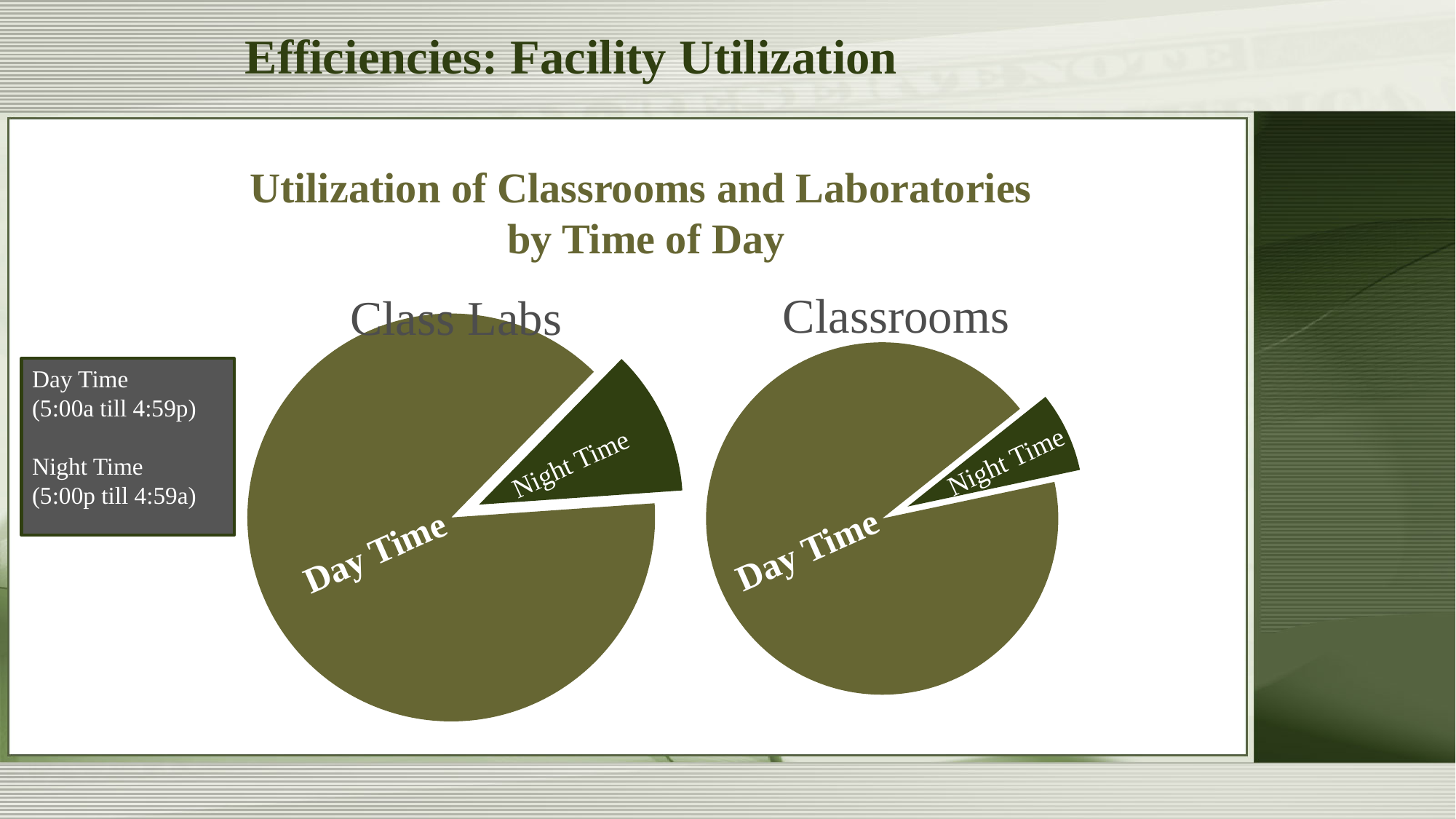
In the Classrooms pie chart, is the Day Time slice larger or smaller than the Night Time slice? Larger What is the overall title shown above the two pie charts? Utilization of Classrooms and Laboratories by Time of Day In the Class Labs pie chart, which slice is the smallest? Night Time What kind of chart is the Classrooms chart? Pie chart How many slices does the Classrooms pie chart have? 2 In the Classrooms pie chart, which slice is the largest? Day Time Which chart has the larger Night Time share, Class Labs or Classrooms? Class Labs In the Class Labs pie chart, which slice is the largest? Day Time According to the legend box, what hours does Night Time cover? 5:00p till 4:59a In the Classrooms pie chart, which slice is the smallest? Night Time How many slices does the Class Labs pie chart have? 2 What kind of chart is the Class Labs chart? Pie chart